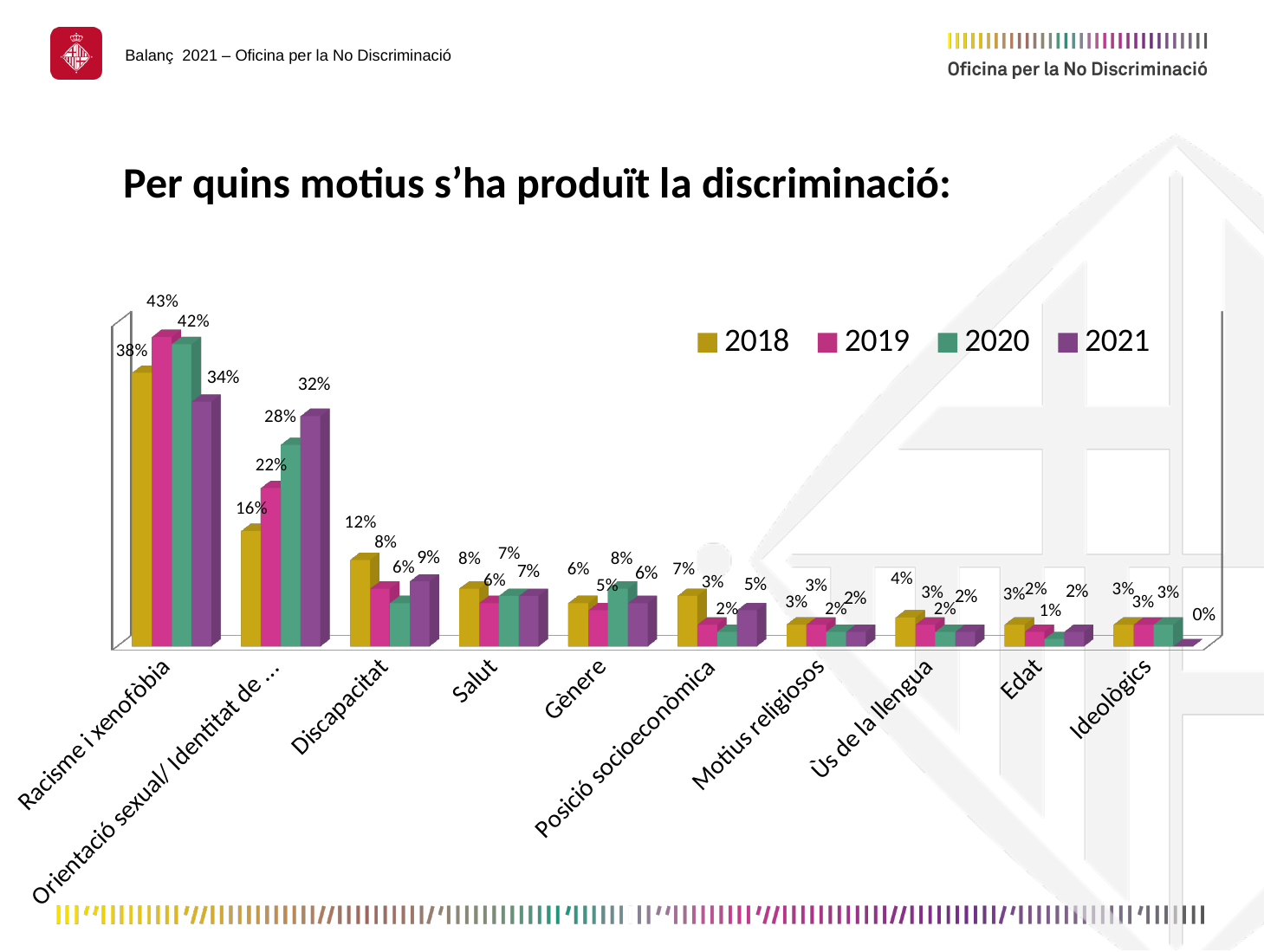
What was the value for Ideològics in 2021? 0% How many series does the legend list? 4 What kind of chart is shown on the slide? Bar chart How many categories are shown on the x axis? 10 What was the value for Racisme i xenofòbia in 2019? 43% What was the value for Discapacitat in 2018? 12% What is the difference between the 2018 and 2021 values for Orientació sexual/ Identitat de ...? 16% Which was larger for Gènere: the 2020 value or the 2019 value? 2020 Which category had the lowest value in 2021? Ideològics Did the value for Orientació sexual/ Identitat de ... rise or fall from 2018 to 2021? Rise What was the value for Orientació sexual/ Identitat de ... in 2021? 32% Which category had the highest value in 2021? Racisme i xenofòbia